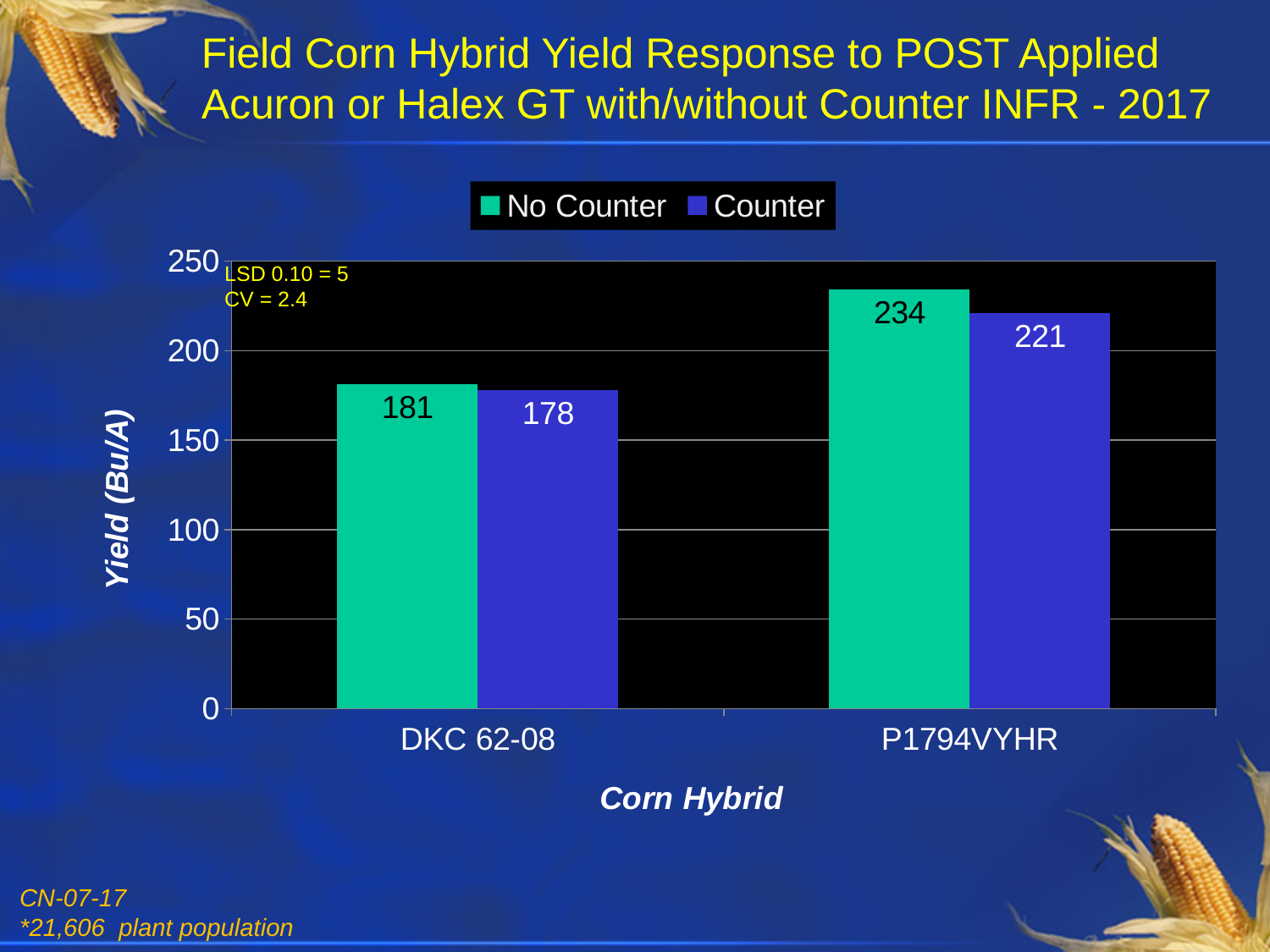
What is the difference between the No Counter yields of P1794VYHR and DKC 62-08? 53 What is the yield for DKC 62-08 with No Counter? 181 Which bar shows the lowest yield on the chart? DKC 62-08 Counter Which is larger for DKC 62-08, the No Counter yield or the Counter yield? No Counter What is the yield for DKC 62-08 with Counter? 178 Is the Counter yield for P1794VYHR greater or less than 200? greater How many series does the legend list? 2 What kind of chart is shown on the slide? bar chart What is the yield for P1794VYHR with Counter? 221 How many corn hybrids are shown on the x axis? 2 Which hybrid has the highest No Counter yield? P1794VYHR What is the difference between the No Counter and Counter yields for P1794VYHR? 13